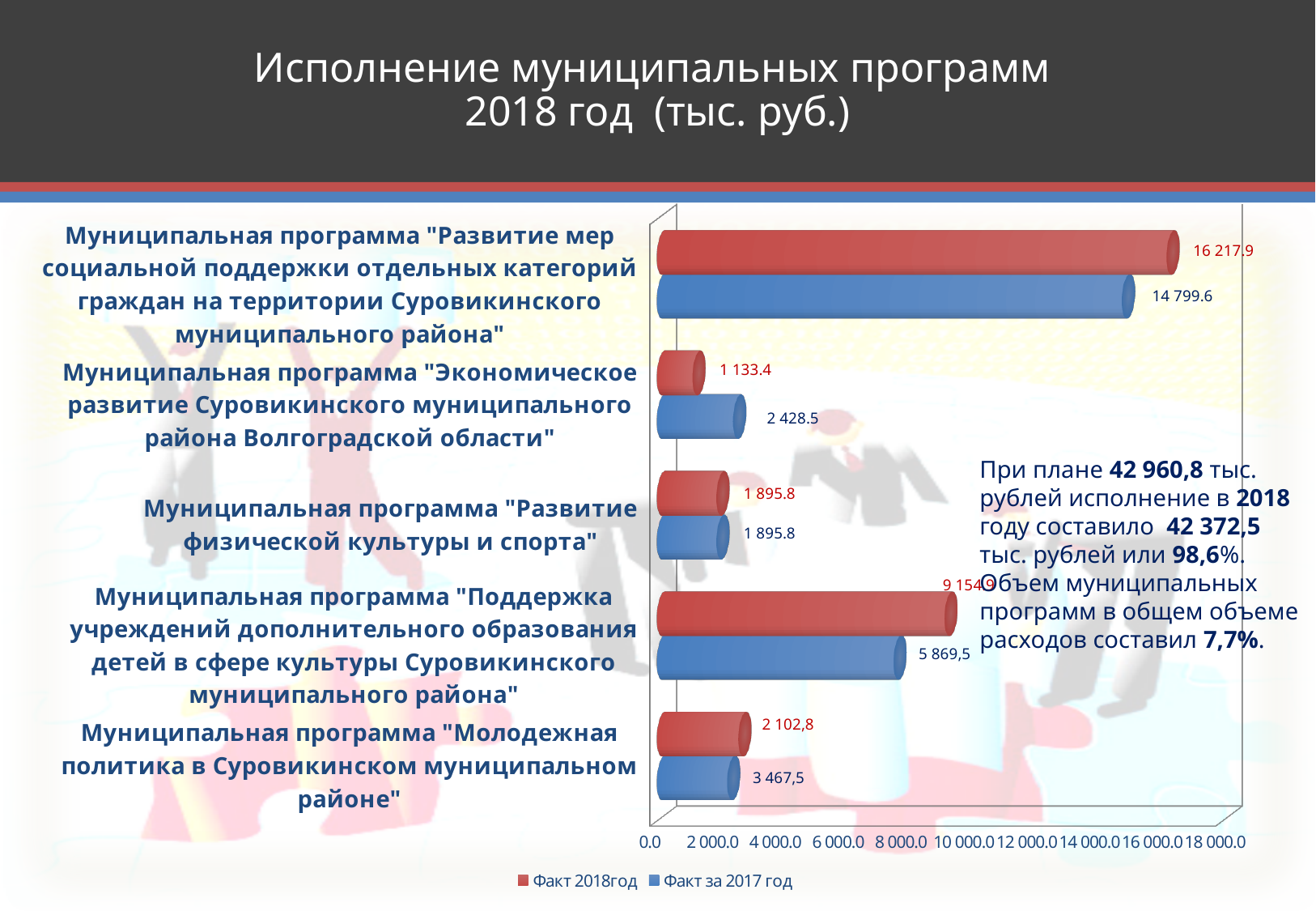
What is the value of "Факт за 2017 год" for the program "Экономическое развитие Суровикинского муниципального района Волгоградской области"? 2 428.5 Which program has the highest "Факт 2018год" value? Муниципальная программа "Развитие мер социальной поддержки отдельных категорий граждан на территории Суровикинского муниципального района" What type of chart is shown on the slide? bar chart How many municipal programs are shown on the chart? 5 Is the "Факт 2018год" value for the program "Поддержка учреждений дополнительного образования детей в сфере культуры..." greater or less than 8 000.0? greater For the program "Развитие мер социальной поддержки...", how much larger is the "Факт 2018год" value than the "Факт за 2017 год" value? 1 418.3 For the program "Молодежная политика в Суровикинском муниципальном районе", what is the difference between the "Факт за 2017 год" and "Факт 2018год" values? 1 364,7 What is the value of "Факт за 2017 год" for the program "Молодежная политика в Суровикинском муниципальном районе"? 3 467,5 What is the value of "Факт 2018год" for the program "Развитие мер социальной поддержки отдельных категорий граждан на территории Суровикинского муниципального района"? 16 217.9 How many series does the chart legend list? 2 For the program "Экономическое развитие Суровикинского муниципального района Волгоградской области", which is larger: "Факт 2018год" or "Факт за 2017 год"? Факт за 2017 год Which program has the lowest "Факт 2018год" value? Муниципальная программа "Экономическое развитие Суровикинского муниципального района Волгоградской области"